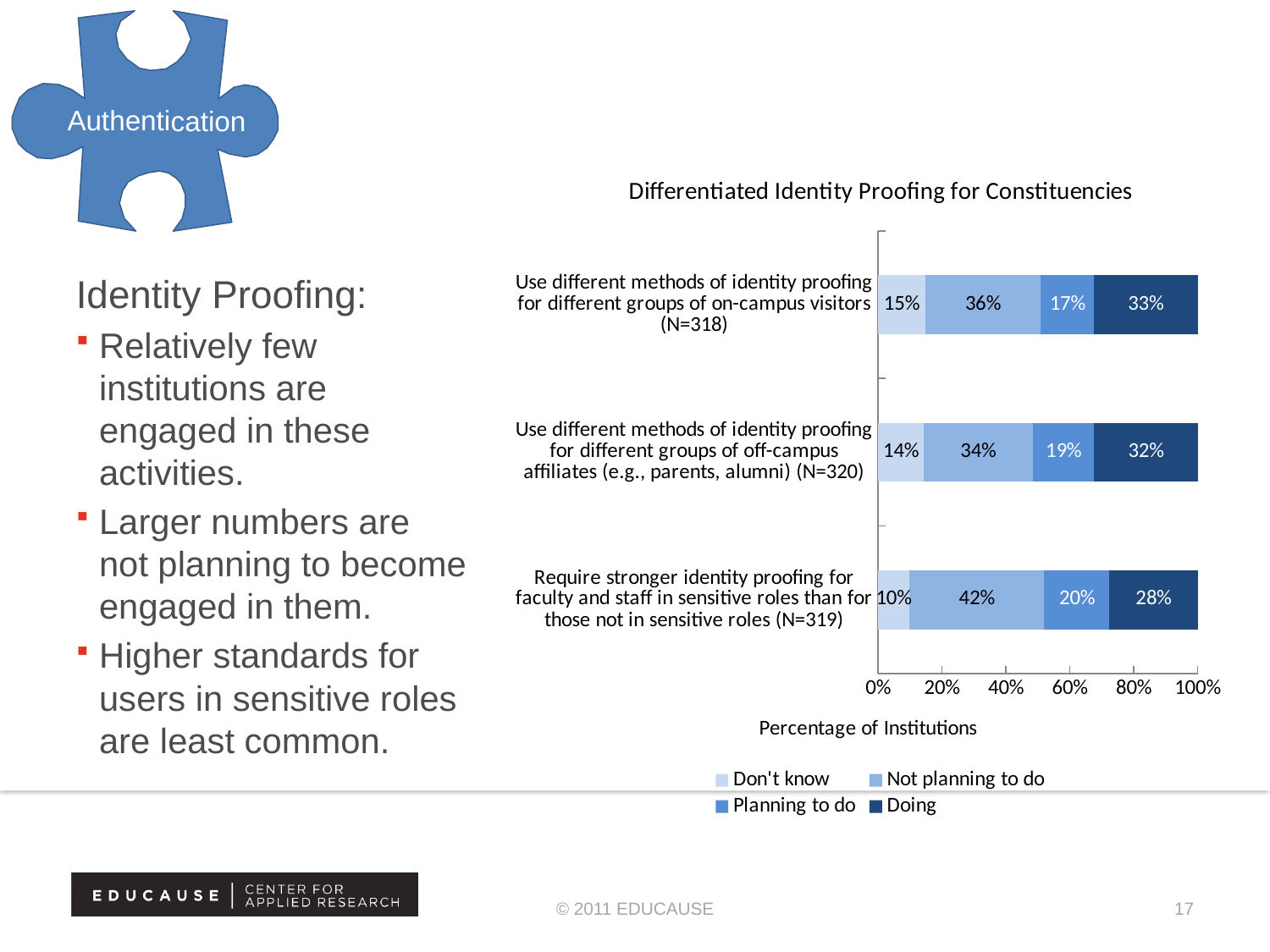
What percentage of institutions are 'Not planning to do' stronger identity proofing for faculty and staff in sensitive roles? 42% What percentage of institutions are 'Doing' different methods of identity proofing for different groups of on-campus visitors? 33% How many series does the chart legend list? 4 What type of chart is shown on the slide? Stacked bar chart What is the 'Don't know' percentage for using different methods of identity proofing for different groups of off-campus affiliates? 14% Which category has the highest 'Not planning to do' percentage? Require stronger identity proofing for faculty and staff in sensitive roles than for those not in sensitive roles (N=319) What is the difference between the 'Doing' percentage for on-campus visitors and the 'Doing' percentage for faculty and staff in sensitive roles? 5% Is the 'Don't know' percentage larger for on-campus visitors or for faculty and staff in sensitive roles? On-campus visitors Which category has the lowest 'Doing' percentage? Require stronger identity proofing for faculty and staff in sensitive roles than for those not in sensitive roles (N=319) How many categories (bars) are plotted in the chart? 3 What is the title of the chart? Differentiated Identity Proofing for Constituencies What is the 'Planning to do' percentage for requiring stronger identity proofing for faculty and staff in sensitive roles? 20%